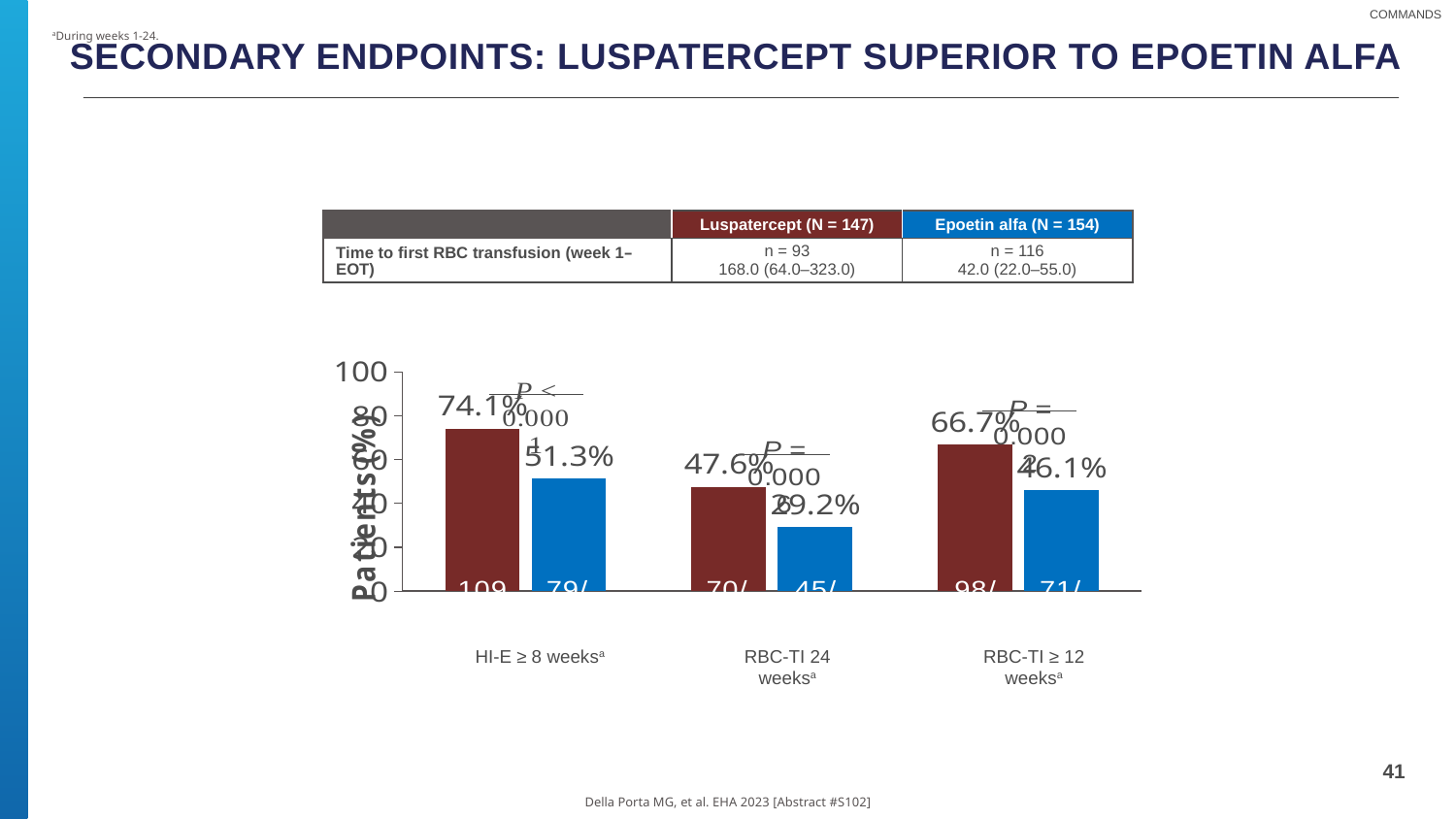
What is the difference between the dark red and blue bars for HI-E ≥ 8 weeks? 22.8 percentage points What is the value of the dark red bar for RBC-TI ≥ 12 weeks? 66.7% What is the value of the blue bar for RBC-TI ≥ 12 weeks? 46.1% What is the value of the dark red bar for HI-E ≥ 8 weeks? 74.1% What is the value of the blue bar for HI-E ≥ 8 weeks? 51.3% For RBC-TI ≥ 12 weeks, which bar is larger, the dark red or the blue? dark red Which category has the lowest blue bar? RBC-TI 24 weeks What is the value of the dark red bar for RBC-TI 24 weeks? 47.6% How many categories are shown on the x axis of the chart? 3 What kind of chart is shown on the slide? bar chart What is the value of the blue bar for RBC-TI 24 weeks? 29.2% Which category has the highest dark red bar? HI-E ≥ 8 weeks